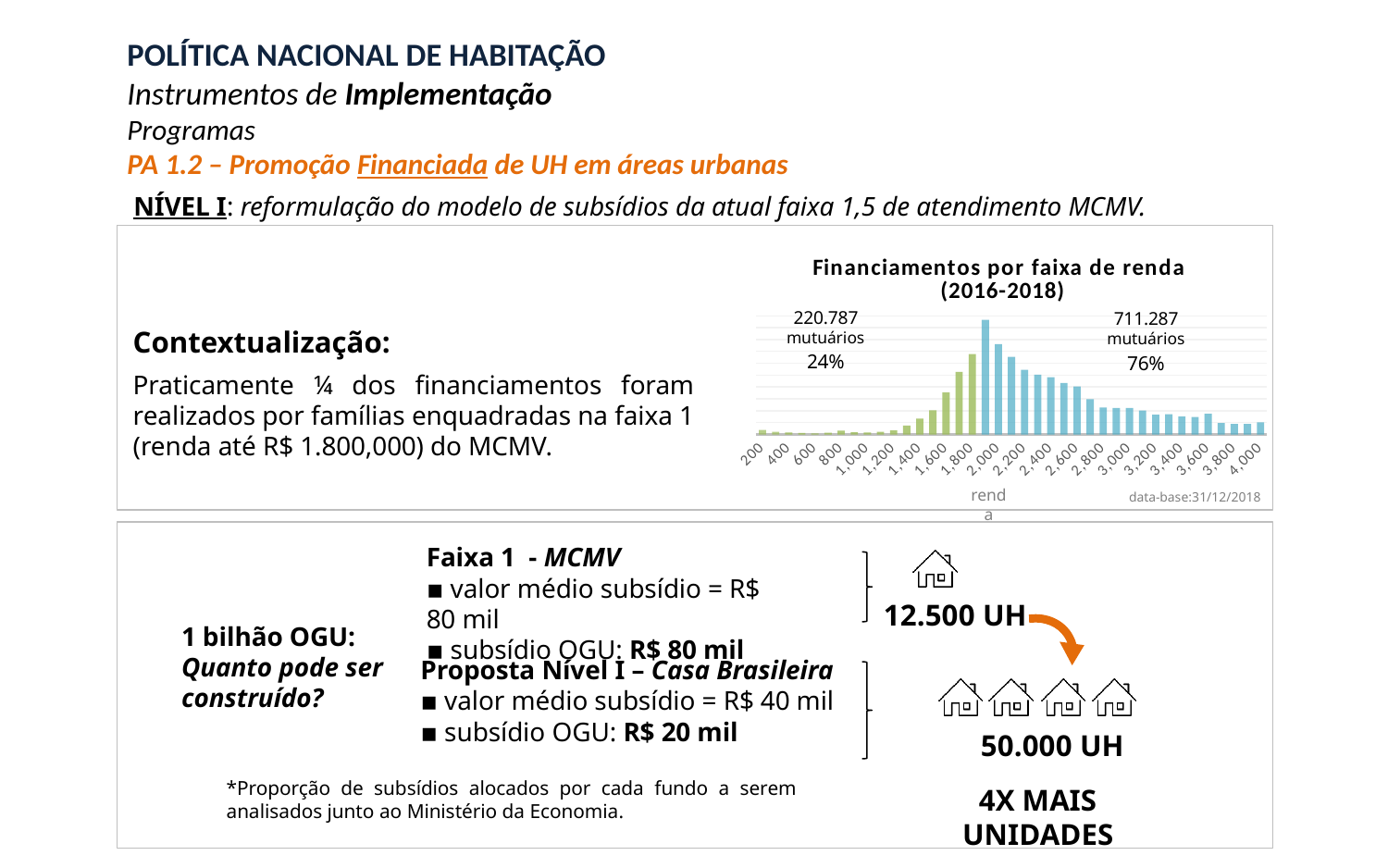
Which group has more mutuários, the green group (24%) or the blue group (76%)? the blue group What label is shown on the x axis of the chart? renda Do the bar values rise or fall along the x axis from renda 2,000 to 4,000? fall What is the title of the chart? Financiamentos por faixa de renda (2016-2018) What is the difference in mutuários between the blue group (711.287) and the green group (220.787)? 490.500 How many mutuários are in the blue group (renda above 1,800) according to the chart annotation? 711.287 mutuários What kind of chart is shown on the slide? bar chart How many mutuários are in the green group (up to renda 1,800) according to the chart annotation? 220.787 mutuários What percentage of financiamentos does the green group (renda up to 1,800) represent? 24% What percentage of financiamentos does the blue group (renda above 1,800) represent? 76% What is the data-base date noted below the chart? 31/12/2018